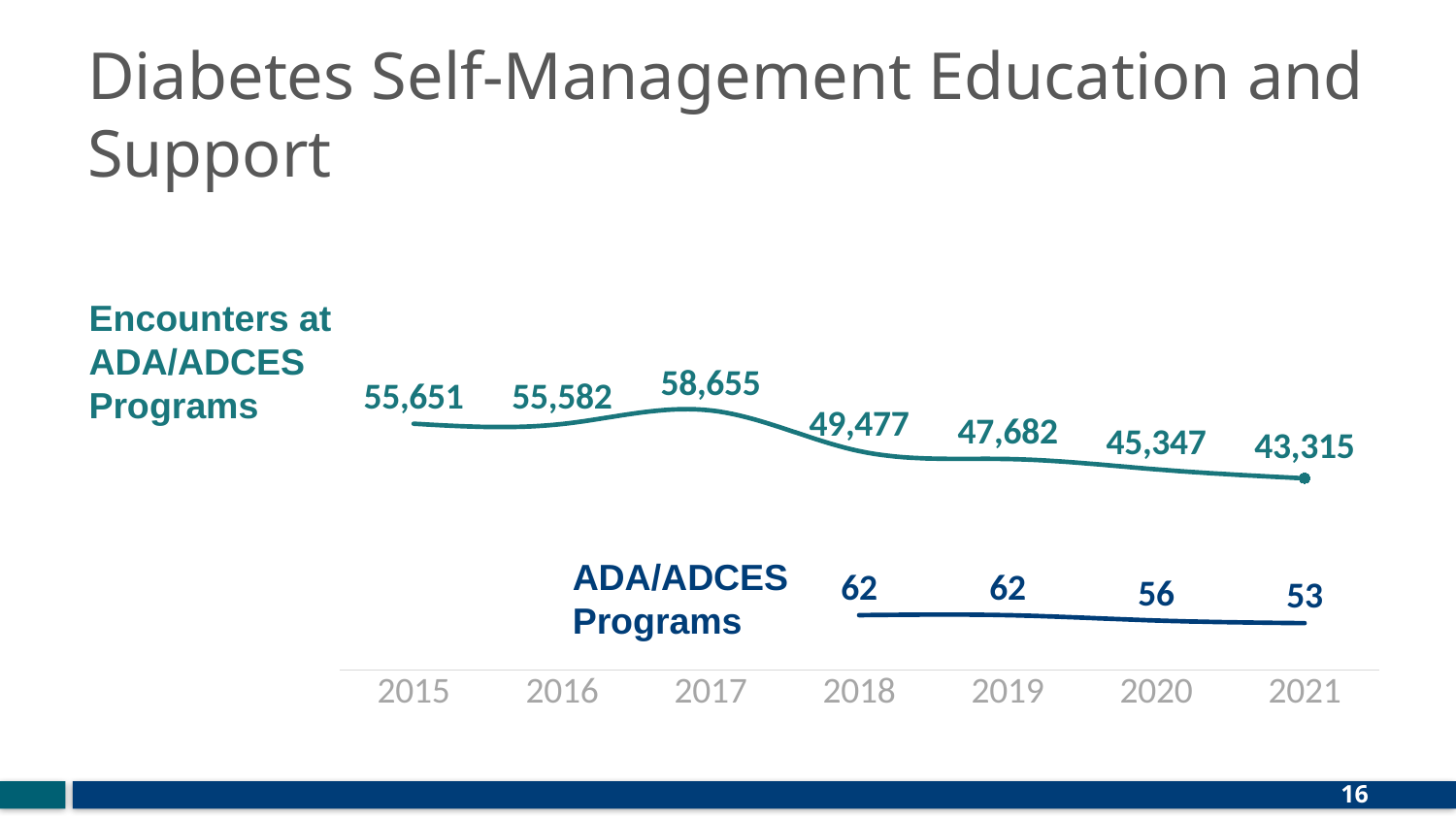
What was the number of encounters at ADA/ADCES Programs in 2017? 58,655 Which year had more encounters at ADA/ADCES Programs, 2019 or 2020? 2019 In which year were encounters at ADA/ADCES Programs highest? 2017 How many ADA/ADCES Programs were there in 2020? 56 What kind of chart is shown on the slide? Line chart How many years are shown on the x axis of the chart? 7 What was the number of encounters at ADA/ADCES Programs in 2021? 43,315 Do encounters at ADA/ADCES Programs rise or fall from 2017 to 2021? Fall By how much did the number of ADA/ADCES Programs fall from 2018 to 2021? 9 In which year were encounters at ADA/ADCES Programs lowest? 2021 What is the difference between encounters at ADA/ADCES Programs in 2017 and 2018? 9,178 How many data points are plotted for the ADA/ADCES Programs series? 4